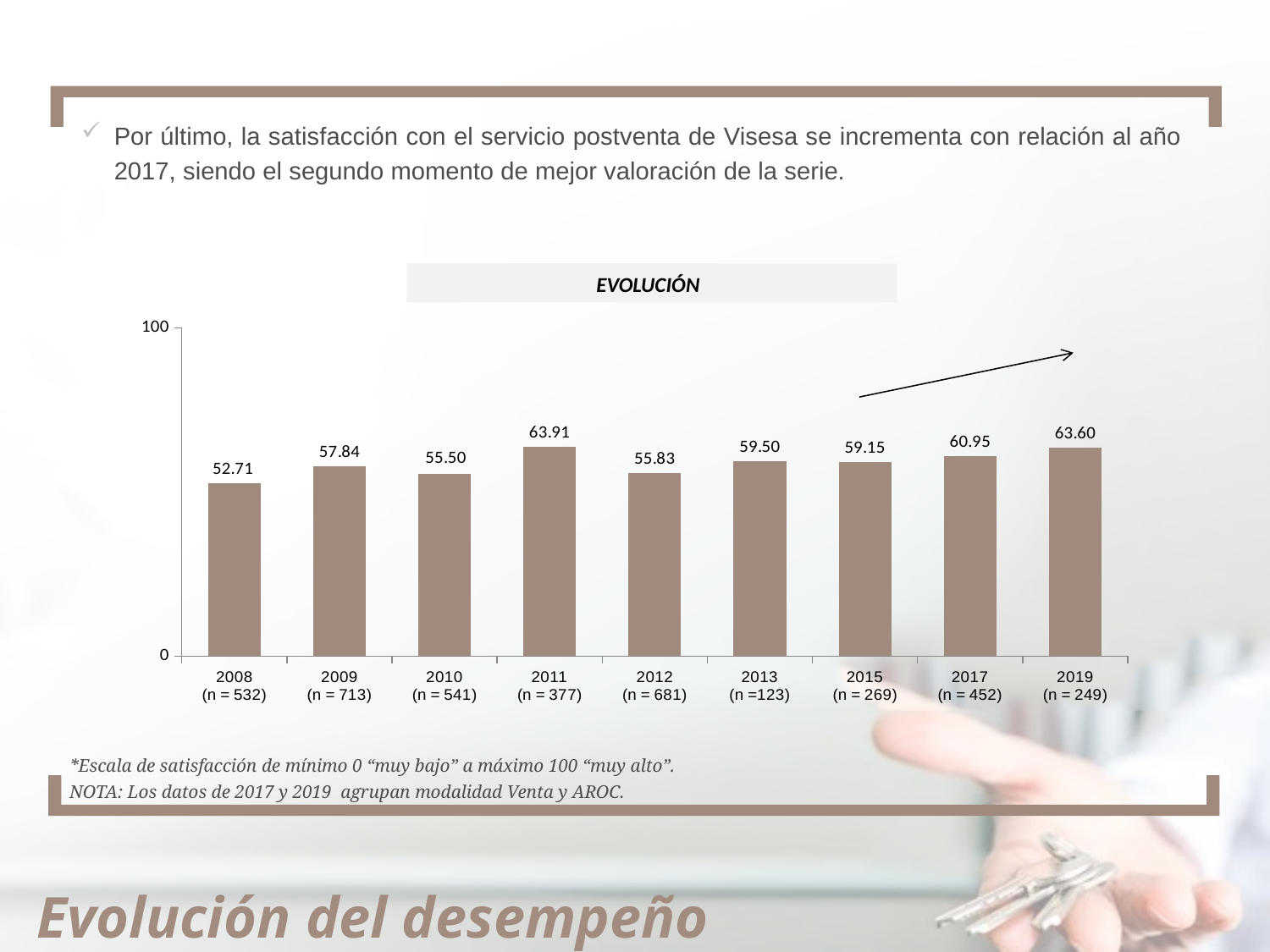
Which is larger in the EVOLUCIÓN chart, the value for 2013 or the value for 2015? 2013 What is the title of the chart on the slide? EVOLUCIÓN How many years are shown on the x axis of the EVOLUCIÓN chart? 9 Which year has the highest value in the EVOLUCIÓN chart? 2011 Which year has the lowest value in the EVOLUCIÓN chart? 2008 What is the value shown for 2008 in the EVOLUCIÓN chart? 52.71 What is the difference between the values for 2019 and 2017 in the EVOLUCIÓN chart? 2.65 Does the value rise or fall from 2017 to 2019 in the EVOLUCIÓN chart? rise Is the value for 2012 in the EVOLUCIÓN chart greater or less than 100? less What is the value shown for 2017 in the EVOLUCIÓN chart? 60.95 What is the value shown for 2019 in the EVOLUCIÓN chart? 63.60 What kind of chart is the EVOLUCIÓN chart? bar chart